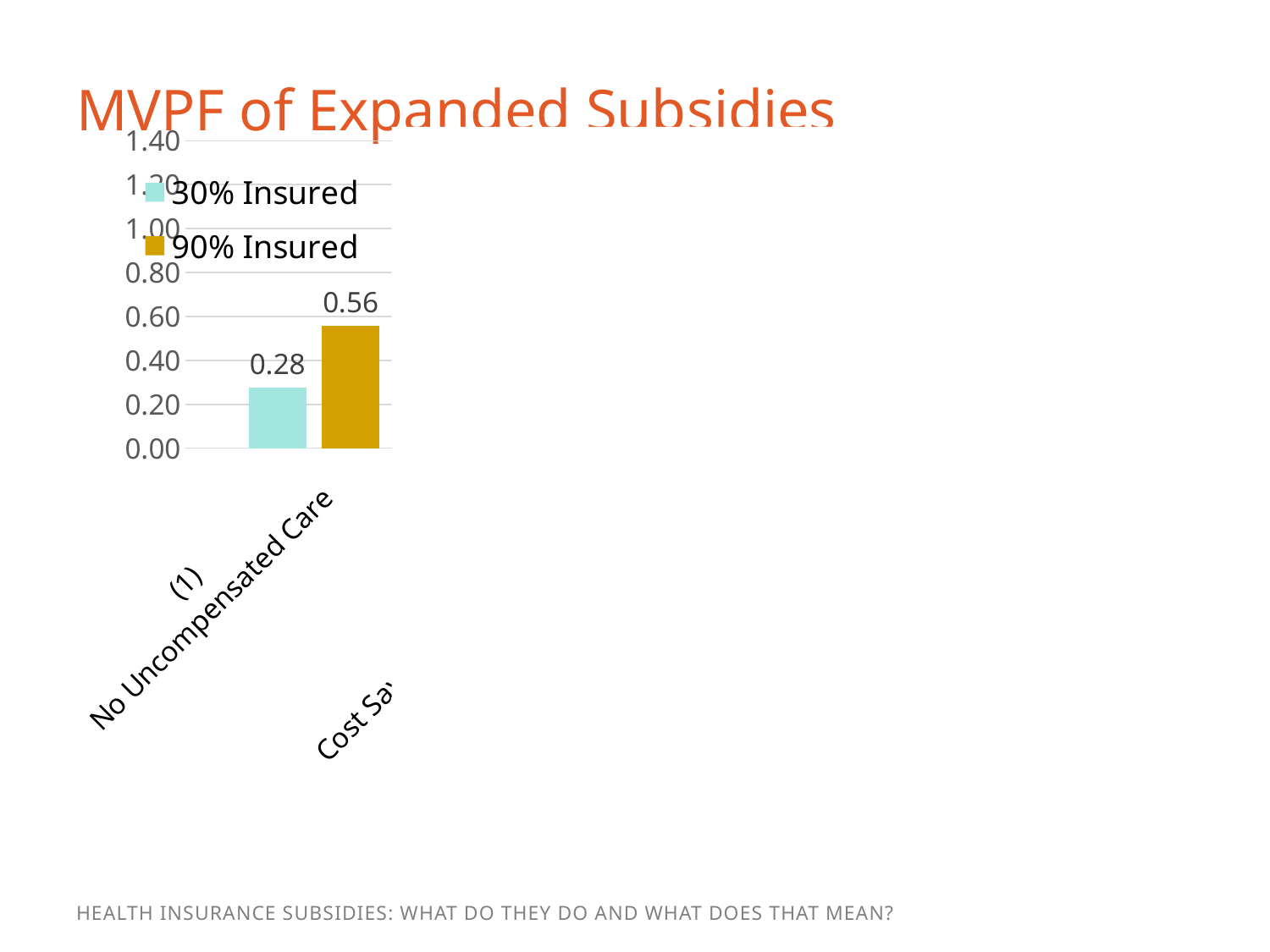
What is the value for 90% Insured in the (1) No Uncompensated Care category? 0.56 What kind of chart is shown on the slide? bar chart Is the value for 90% Insured in the (1) No Uncompensated Care category greater or less than 0.40? greater Which series has the higher value for (1) No Uncompensated Care, 30% Insured or 90% Insured? 90% Insured How many series does the legend list? 2 Which series is shown in gold/yellow in the legend? 90% Insured Is the value for 30% Insured in the (1) No Uncompensated Care category greater or less than 0.40? less What is the title of the slide? MVPF of Expanded Subsidies What is the value for 30% Insured in the (1) No Uncompensated Care category? 0.28 What is the highest value shown on the y axis? 1.40 What is the difference between the 90% Insured and 30% Insured values for (1) No Uncompensated Care? 0.28